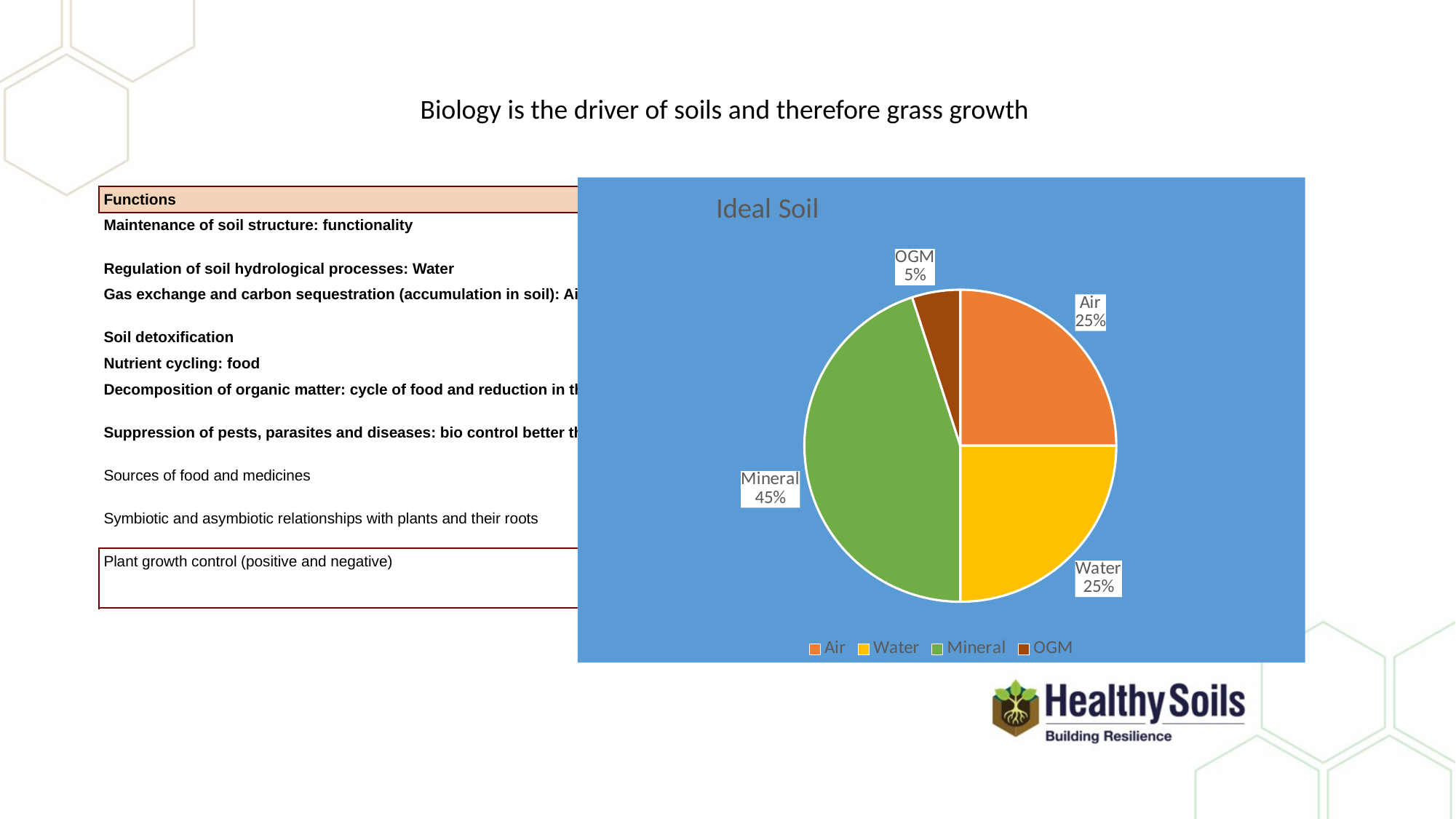
What is the title of the chart? Ideal Soil What share of the pie does OGM take? 5% How many entries does the legend list? 4 What share of the pie does Air take? 25% How many slices does the pie chart have? 4 What kind of chart is shown on the slide? pie chart What is the difference in percentage points between the Mineral and Water slices? 20 Which slice of the pie is the smallest? OGM Which slice of the pie is the largest? Mineral What share of the pie does Mineral take? 45% Which is larger, the Air slice or the OGM slice? Air What colour is the Mineral slice? green